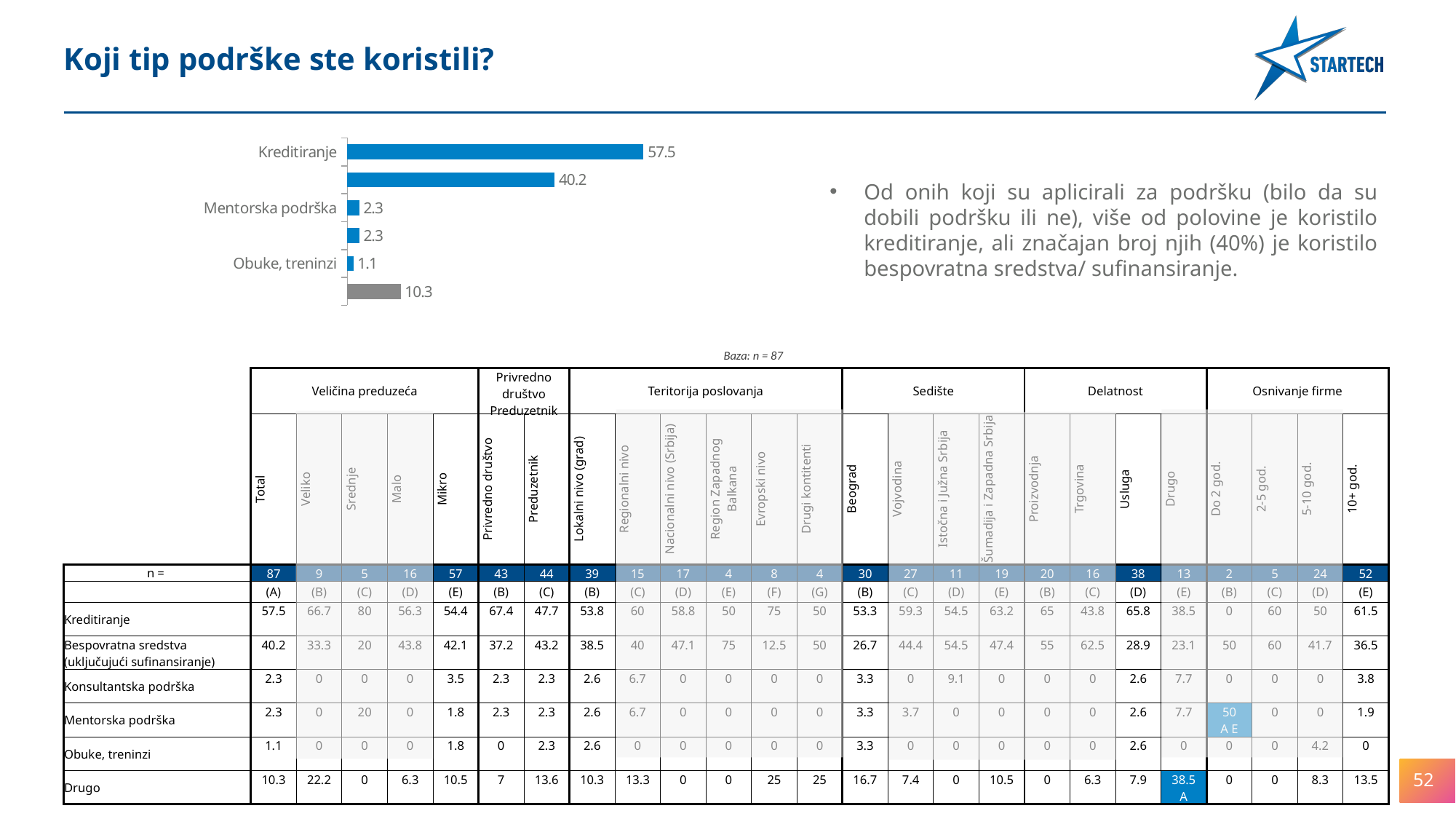
What is the value for Obuke, treninzi in the bar chart? 1.1 What kind of chart is shown on the slide? Bar chart Which category has the lowest value in the bar chart? Obuke, treninzi What is the difference between the values for Kreditiranje and Mentorska podrška in the bar chart? 55.2 How many bars are plotted in the bar chart? 6 What is the difference between the values for Kreditiranje and Obuke, treninzi in the bar chart? 56.4 Which category has the highest value in the bar chart? Kreditiranje What is the value for Kreditiranje in the bar chart? 57.5 What is the value of the second bar from the top in the bar chart? 40.2 Which is larger in the bar chart, the value for Mentorska podrška or the value for Obuke, treninzi? Mentorska podrška What is the value of the bottom (grey) bar in the bar chart? 10.3 What is the value for Mentorska podrška in the bar chart? 2.3